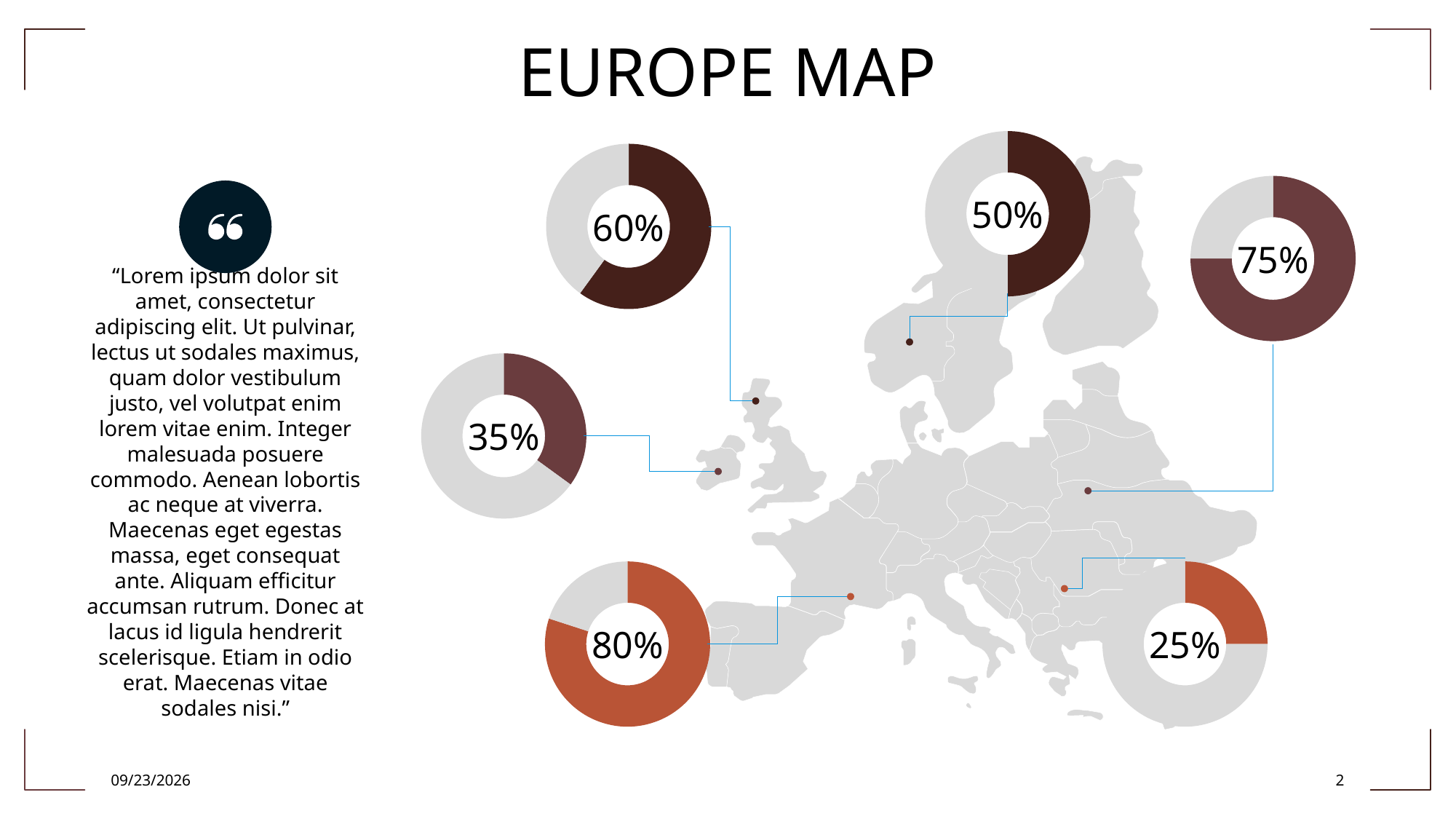
How many donut charts are placed around the map? 6 What is the difference between the value in the top-right donut chart and the value in the bottom-right donut chart? 50% What value is shown in the donut chart at the bottom right? 25% Which donut chart shows the lowest percentage? The bottom-right chart (25%) Which is larger, the value in the top-left donut chart or the value in the middle-left donut chart? The top-left chart (60%) What value is shown in the orange donut chart at the bottom left? 80% What kind of charts are used to show the percentages on the slide? Donut charts What value is shown in the donut chart at the top left of the map? 60% What value is shown in the donut chart at the top right of the slide? 75% What value is shown in the donut chart at the top center of the slide? 50% What value is shown in the donut chart on the middle left, next to the text block? 35% Which donut chart shows the highest percentage? The bottom-left chart (80%)